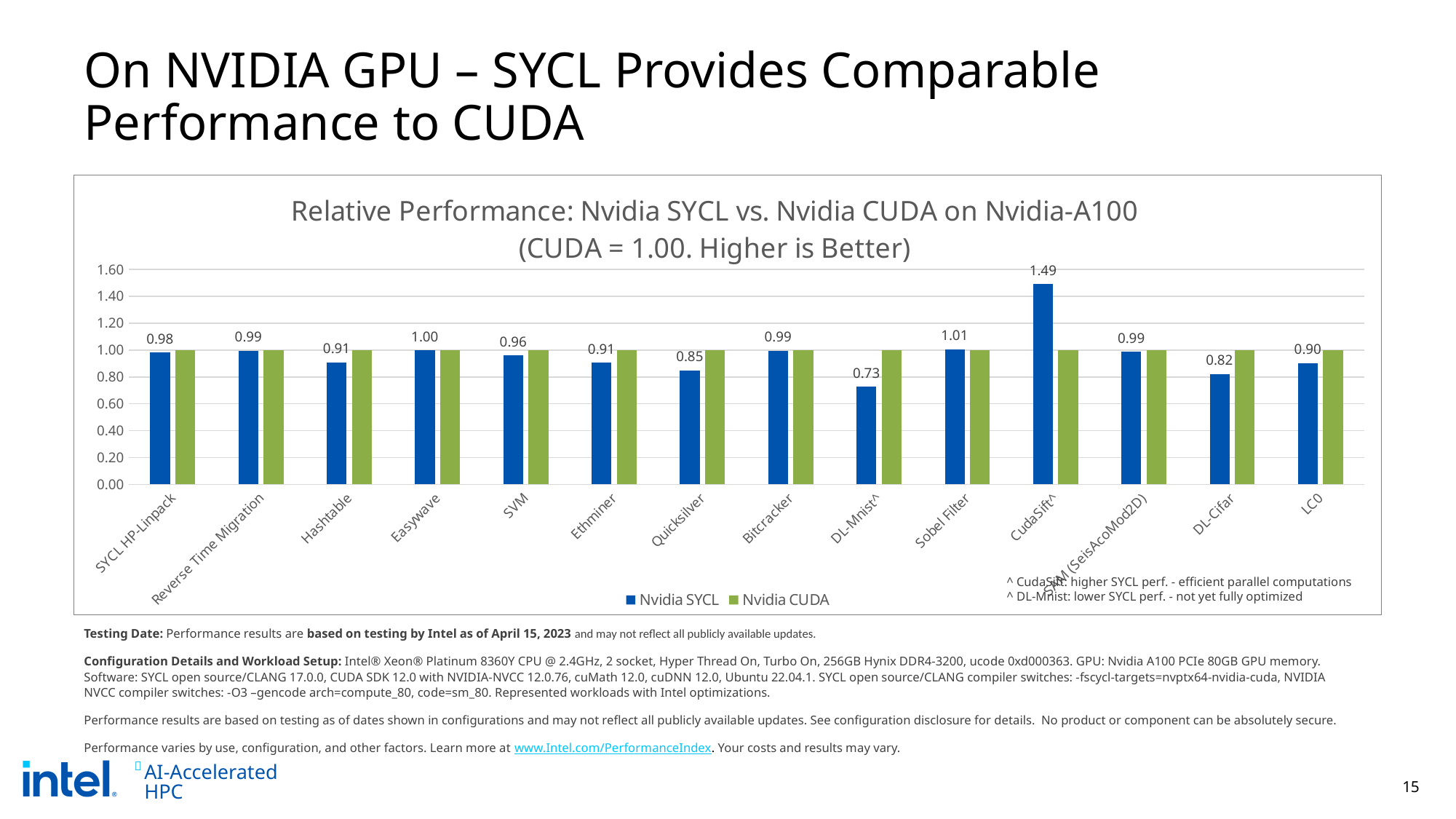
What is the Nvidia SYCL relative performance value for Quicksilver? 0.85 How many series does the chart legend list? 2 How many workloads are shown on the x axis of the chart? 14 Is the Nvidia SYCL value for DL-Cifar greater or less than 1.00? less Which workload has the highest Nvidia SYCL relative performance value? CudaSift What is the difference between the Nvidia SYCL values for CudaSift and DL-Mnist? 0.76 What is the Nvidia SYCL relative performance value for Sobel Filter? 1.01 Which workload has the lowest Nvidia SYCL relative performance value? DL-Mnist Which has a larger Nvidia SYCL value, Hashtable or Easywave? Easywave What is the Nvidia SYCL relative performance value for DL-Mnist? 0.73 What kind of chart is shown on the slide? Bar chart What is the Nvidia SYCL relative performance value for CudaSift? 1.49